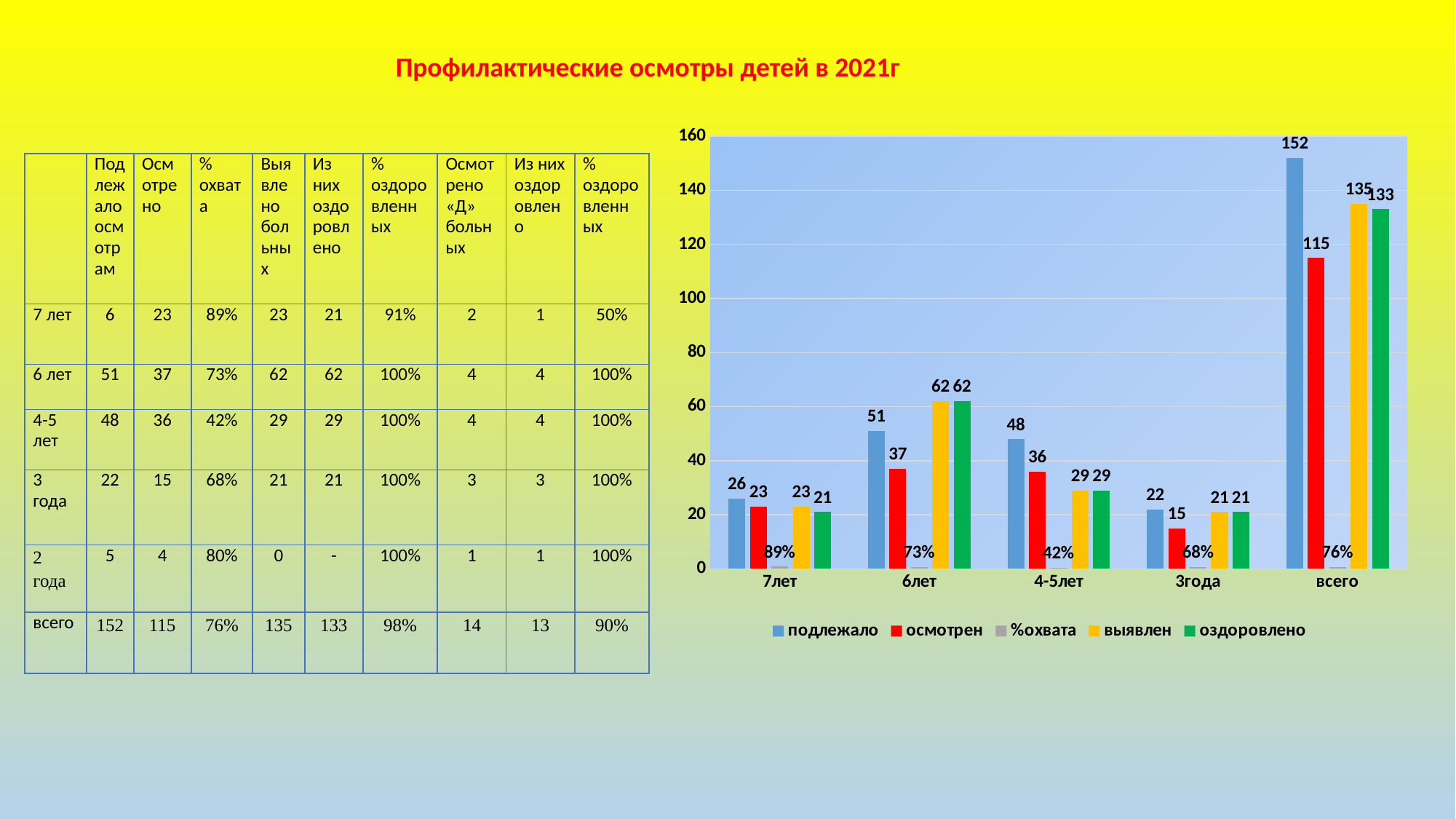
What is the difference between подлежало and осмотрен for всего? 37 How many series does the chart legend list? 5 Which category has the lowest осмотрен value? 3года Which category has the highest подлежало value? всего What is the value of подлежало for всего? 152 What is the %охвата value shown for 4-5лет? 42% What kind of chart is shown on the slide? bar chart Which is larger for 7лет: подлежало or осмотрен? подлежало Which colour represents the оздоровлено series in the chart? green What is the value of осмотрен for 6лет? 37 How many categories are shown on the x axis of the chart? 5 What is the value of выявлен for 3года? 21